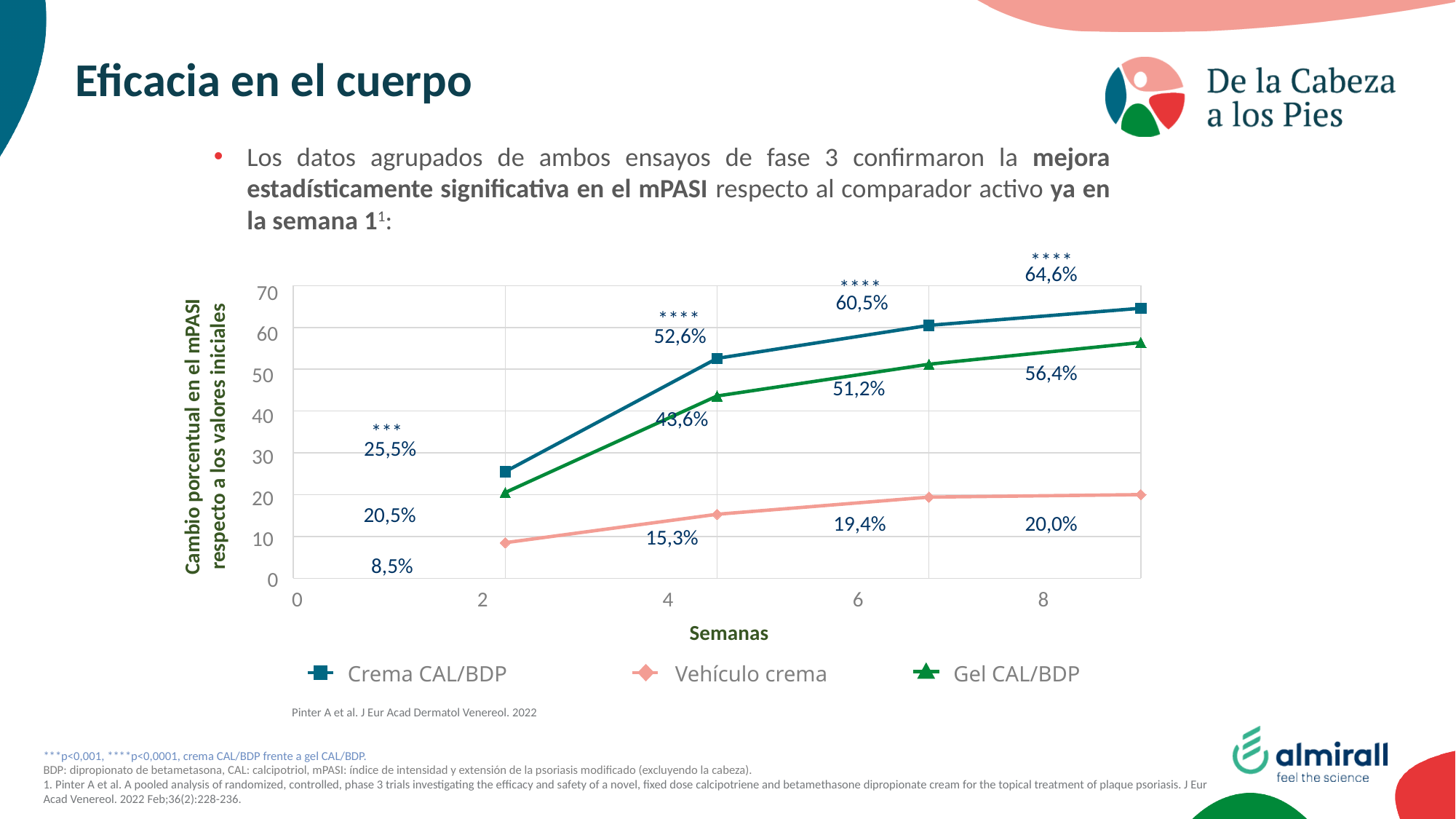
What is the value of the second data point for Gel CAL/BDP? 43,6% What is the value of the third data point for Crema CAL/BDP? 60,5% What kind of chart is shown on the slide? line chart Do the values for Vehículo crema rise or fall along the x axis? rise Which series has the highest value at the final time point? Crema CAL/BDP What is the difference between Crema CAL/BDP and Gel CAL/BDP at the final time point? 8,2% What is the label of the x axis? Semanas At the first time point, which is larger: Crema CAL/BDP or Gel CAL/BDP? Crema CAL/BDP How many series does the legend list? 3 Which series has the lowest value at the first time point? Vehículo crema What is the value of the first (leftmost) data point for Vehículo crema? 8,5% What is the value of the last (rightmost) data point for Crema CAL/BDP? 64,6%